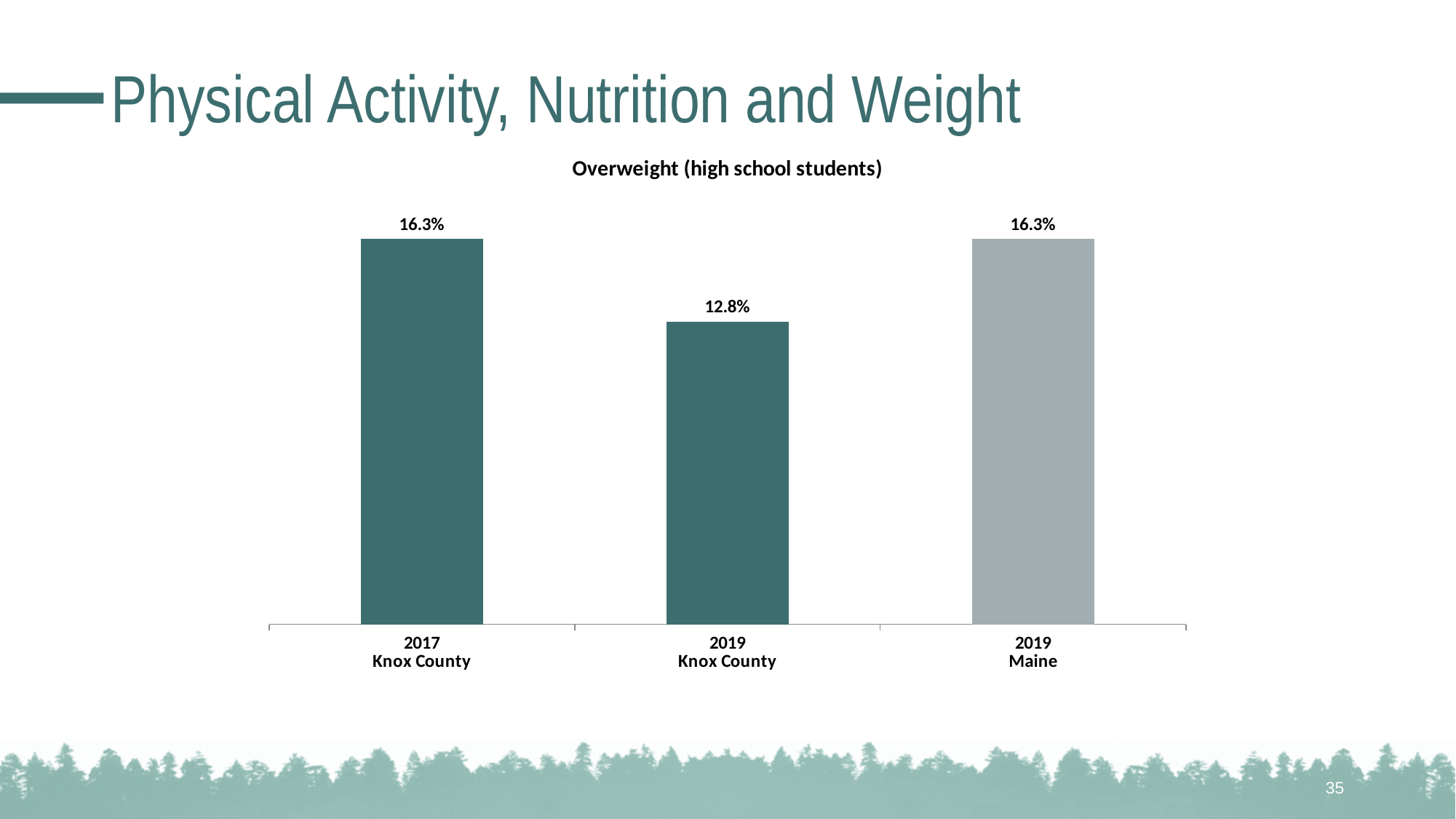
What kind of chart is shown on the slide? Bar chart Which is larger, the value for 2019 Knox County or the value for 2019 Maine? 2019 Maine How many bars are shown in the Overweight (high school students) chart? 3 What is the difference between the 2017 Knox County and 2019 Knox County values? 3.5% Which is larger, the value for 2017 Knox County or the value for 2019 Knox County? 2017 Knox County What is the value for 2019 Knox County in the Overweight (high school students) chart? 12.8% What is the value for 2017 Knox County in the Overweight (high school students) chart? 16.3% Did the Knox County overweight rate rise or fall from 2017 to 2019? Fall Which category has the lowest value in the Overweight (high school students) chart? 2019 Knox County What is the value for 2019 Maine in the Overweight (high school students) chart? 16.3% What is the title of the chart on the slide? Overweight (high school students) What is the difference between the 2019 Maine and 2019 Knox County values? 3.5%